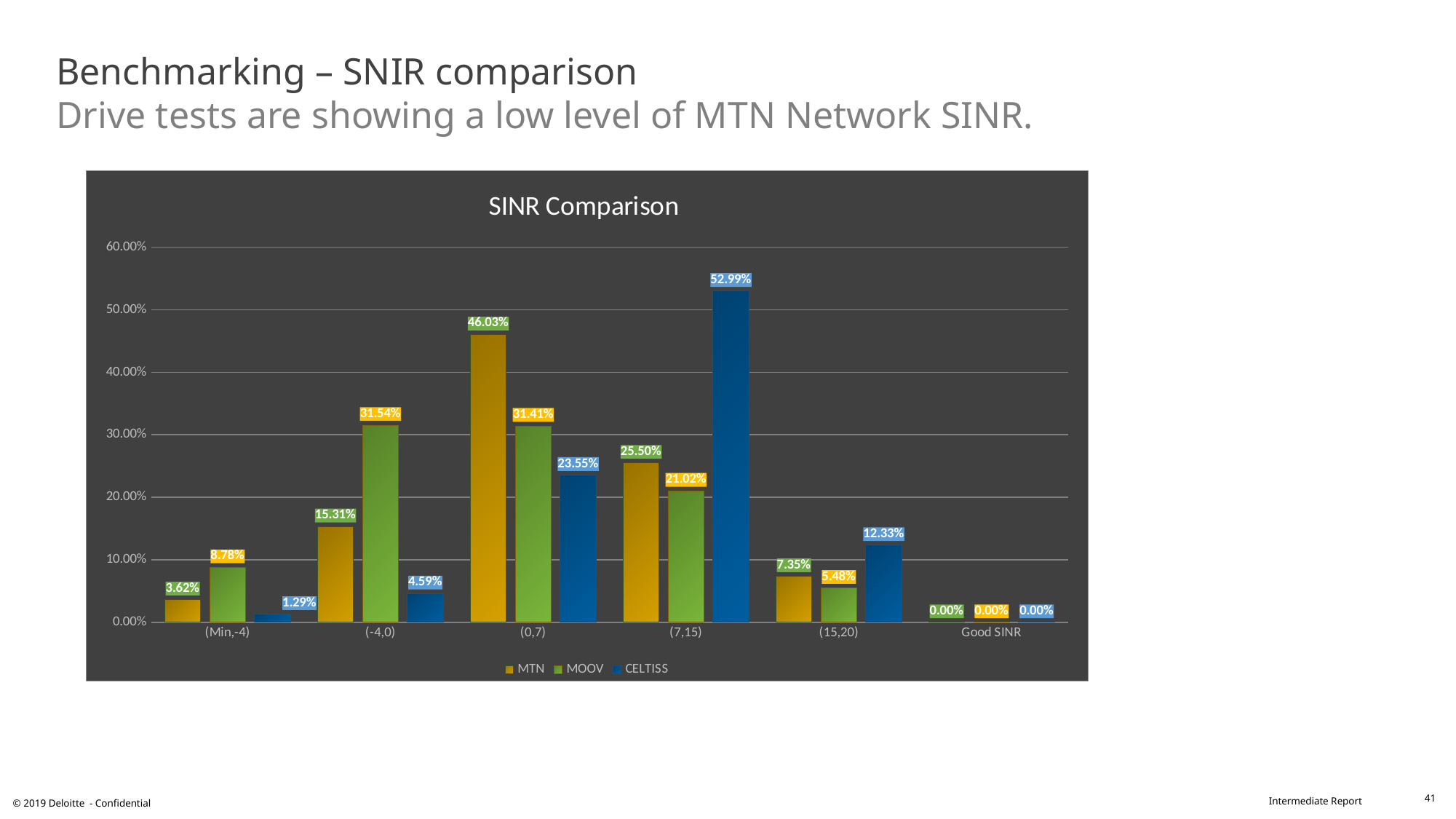
What kind of chart is shown on the slide? bar chart Which is larger in the (15,20) category, the value for MTN or the value for CELTISS? CELTISS Is the value for CELTISS in the (7,15) category greater or less than 50.00%? greater What is the difference between the MTN and MOOV values in the (0,7) category? 14.62% Which series has the highest value in the (7,15) category? CELTISS In which category does MTN reach its highest value? (0,7) What is the value for MTN in the (0,7) category? 46.03% How many categories are shown on the x axis of the SINR Comparison chart? 6 How many series does the legend of the SINR Comparison chart list? 3 What is the value for CELTISS in the (7,15) category? 52.99% What is the title of the chart? SINR Comparison What is the value for MOOV in the (-4,0) category? 31.54%